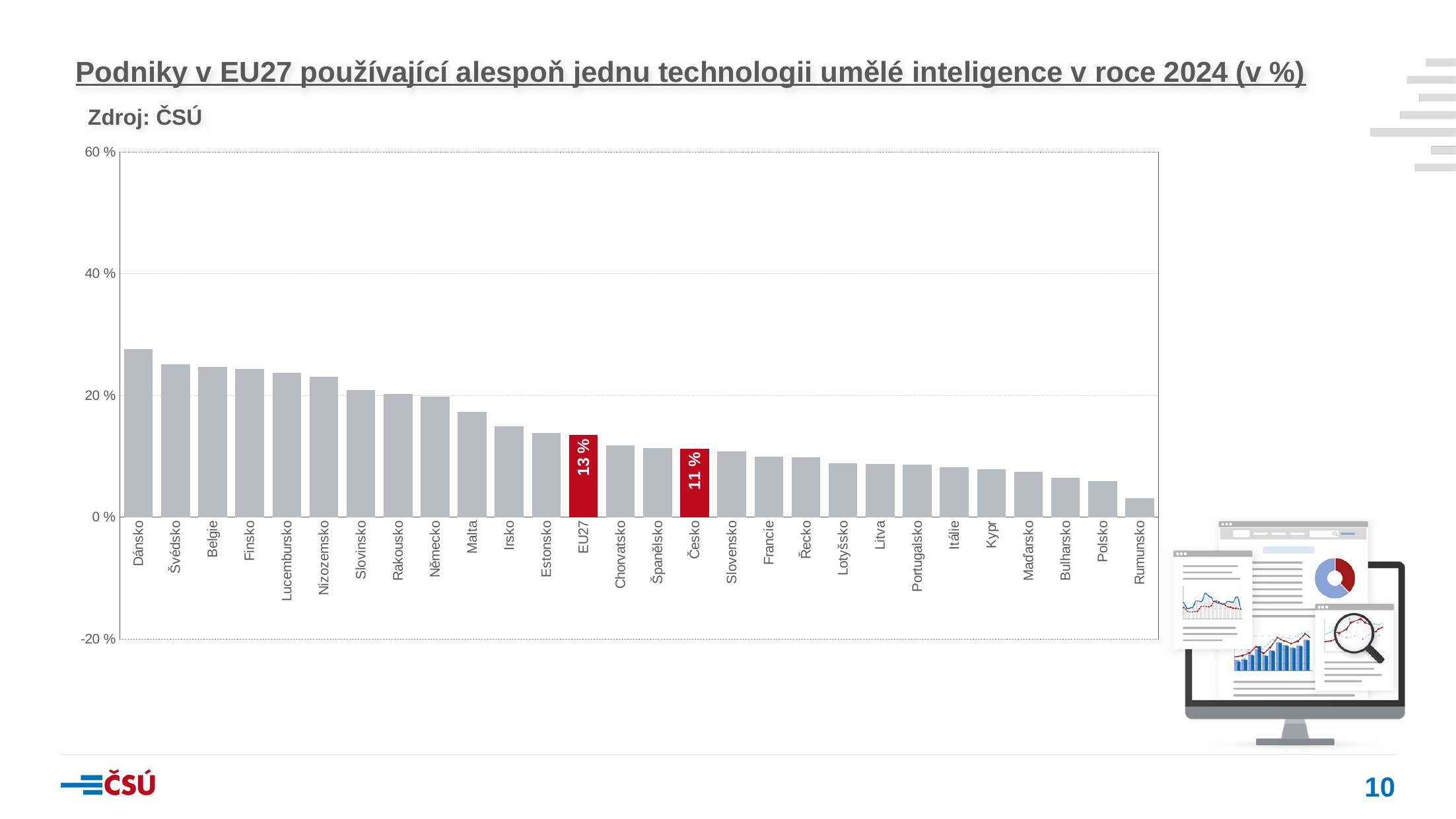
Which category has the highest value? Dánsko What is the value for Česko? 11 % Do the values rise or fall from left to right along the x axis? fall Is the value for Polsko greater or less than 20 %? less Which has a larger value, Dánsko or Rumunsko? Dánsko How many categories are shown on the x axis? 28 What is the value for EU27? 13 % What is the difference between the values for EU27 and Česko? 2 % Which two bars are highlighted in red? EU27 and Česko Is the value for Dánsko greater or less than 20 %? greater What type of chart is shown on the slide? bar chart Which category has the lowest value? Rumunsko